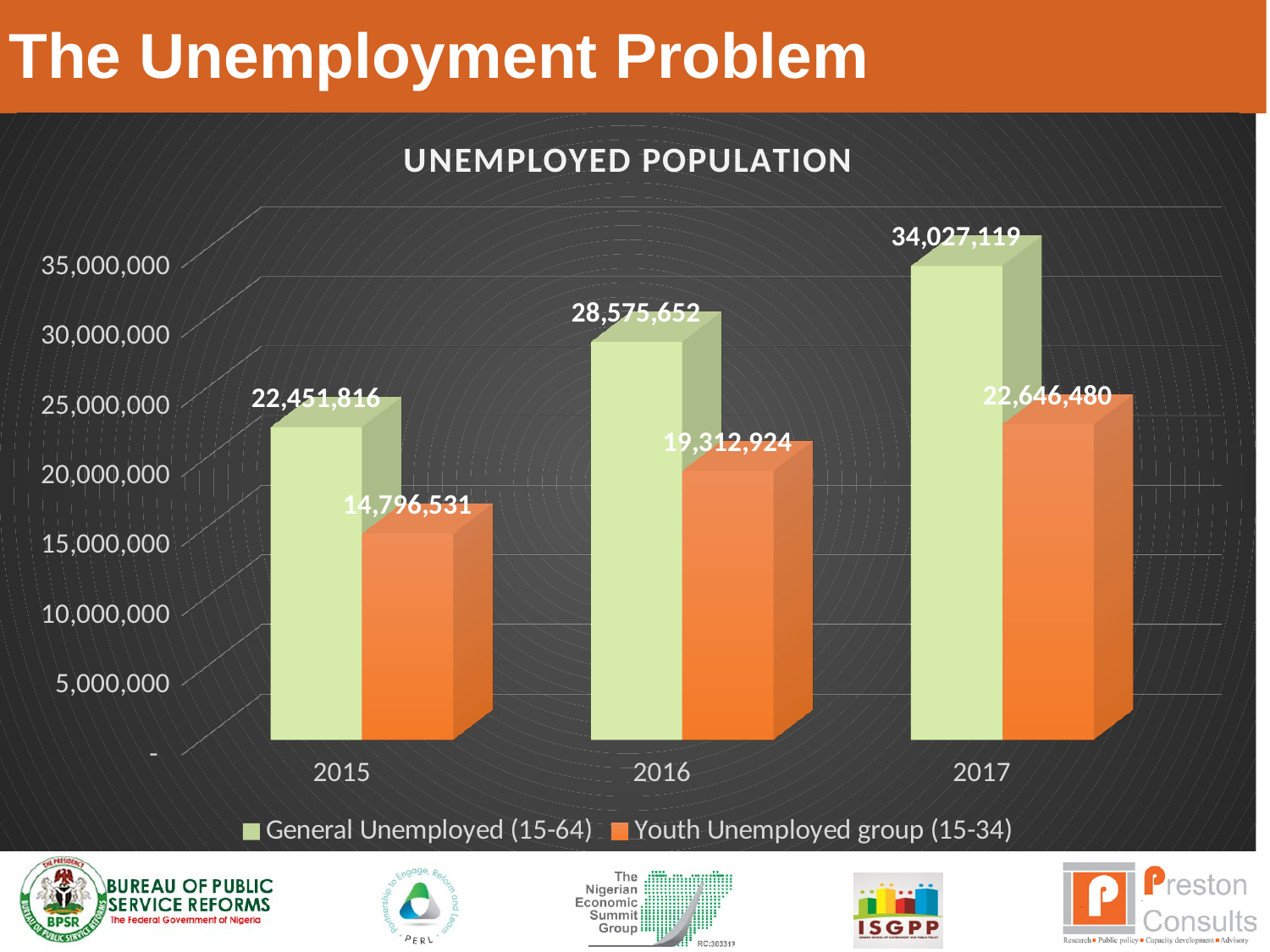
What is the value for General Unemployed (15-64) in 2017? 34,027,119 Do the General Unemployed (15-64) values rise or fall from 2015 to 2017? rise What is the value for General Unemployed (15-64) in 2016? 28,575,652 How many years are shown on the x axis? 3 What is the value for Youth Unemployed group (15-34) in 2017? 22,646,480 In which year is the Youth Unemployed group (15-34) value lowest? 2015 What is the value for Youth Unemployed group (15-34) in 2015? 14,796,531 In which year is the General Unemployed (15-64) value highest? 2017 How many series does the legend list? 2 What is the difference between General Unemployed (15-64) and Youth Unemployed group (15-34) in 2017? 11,380,639 By how much did General Unemployed (15-64) increase from 2015 to 2017? 11,575,303 Which is larger: Youth Unemployed group (15-34) in 2017 or General Unemployed (15-64) in 2015? Youth Unemployed group (15-34) in 2017